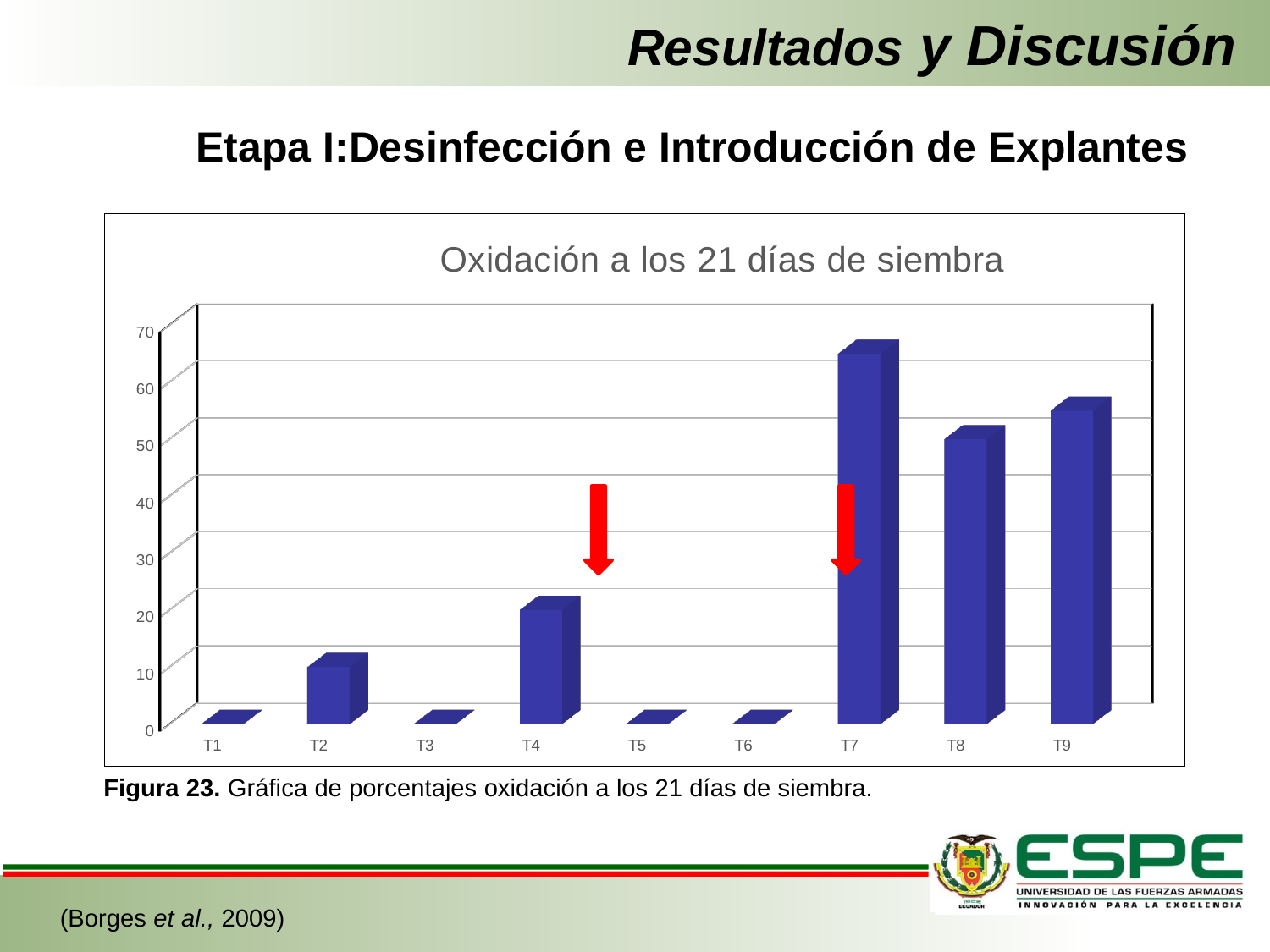
How many treatments have a value of 0? 4 Is the value for T7 greater or less than 60? greater Is the value for T2 greater or less than 20? less Which is larger, the value for T7 or the value for T9? T7 What is the title of the chart? Oxidación a los 21 días de siembra Is the value for T8 greater or less than 40? greater Which is larger, the value for T4 or the value for T2? T4 How many categories (treatments) are shown on the x axis? 9 Which treatment has the highest oxidation value? T7 What is the value for T1? 0 What kind of chart is shown on the slide? bar chart